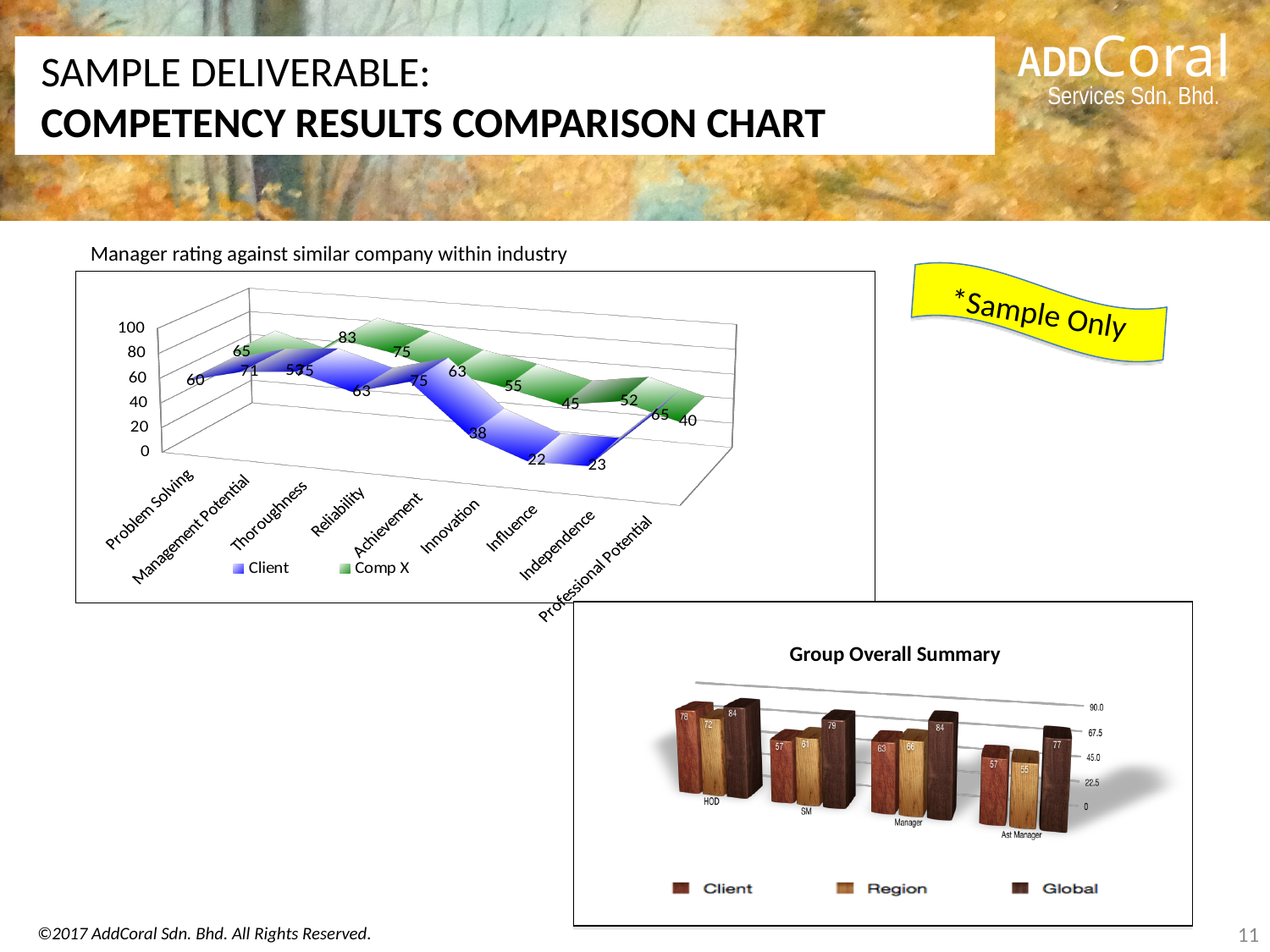
In the 'Manager rating against similar company within industry' chart, what is the Client value for Influence? 22 In the 'Manager rating against similar company within industry' chart, which category has the highest Comp X value? Thoroughness In the 'Manager rating against similar company within industry' chart, which category has the lowest Client value? Influence What kind of chart is the 'Group Overall Summary' chart? Bar chart In the 'Manager rating against similar company within industry' chart, what is the difference between the Comp X and Client values for Influence? 23 In the 'Group Overall Summary' chart, what is the difference between the Global and Client values for SM? 22 In the 'Manager rating against similar company within industry' chart, how many competency categories are shown on the x axis? 9 In the 'Manager rating against similar company within industry' chart, what is the Comp X value for Thoroughness? 83 In the 'Group Overall Summary' chart, what is the Region value for SM? 61 In the 'Manager rating against similar company within industry' chart, which series has the larger value for Innovation, Client or Comp X? Comp X In the 'Manager rating against similar company within industry' chart, how many series does the legend list? 2 In the 'Group Overall Summary' chart, how many series does the legend list? 3